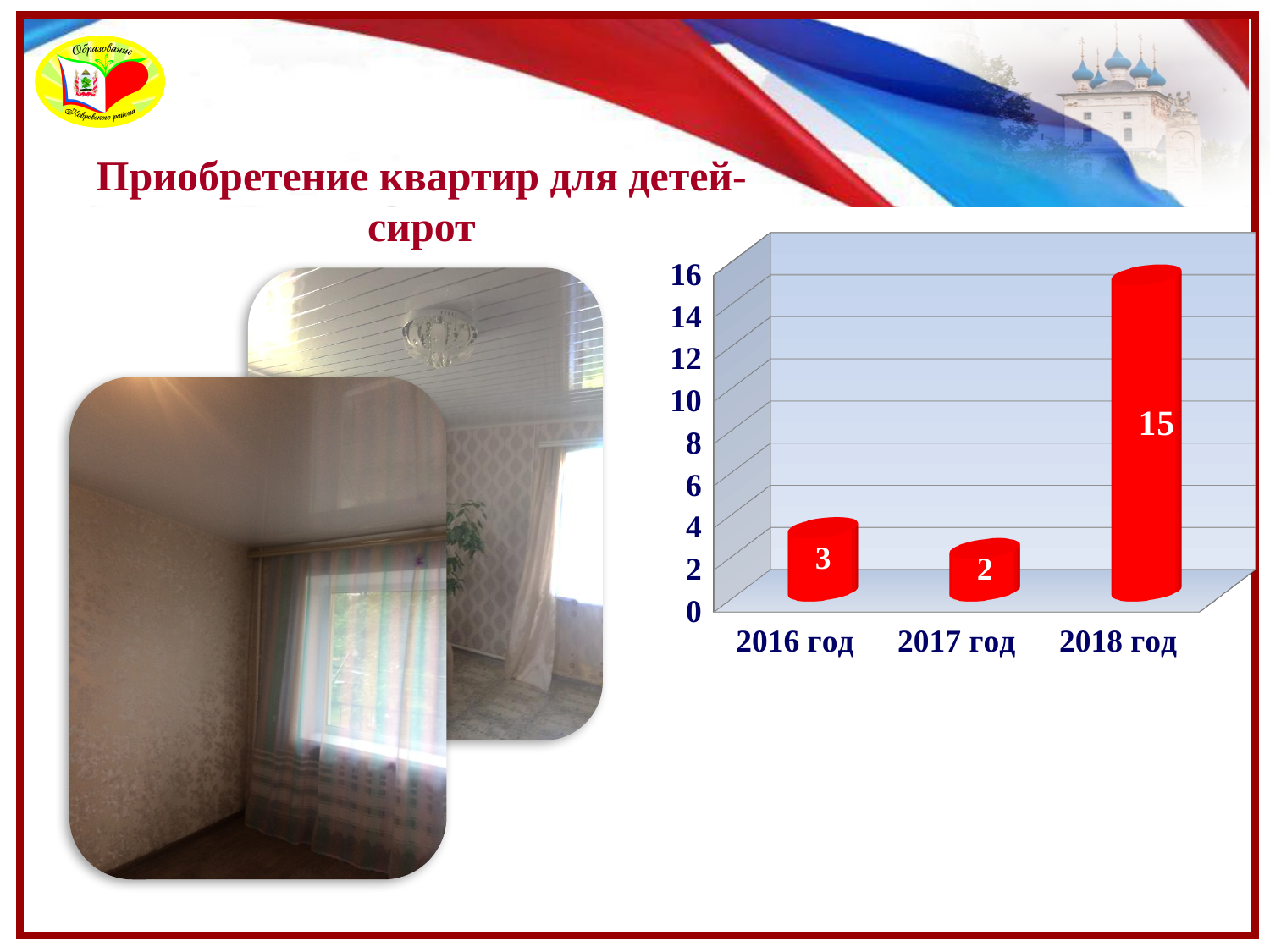
How many years are shown on the chart? 3 Which year has the highest value? 2018 год What is the difference between the values for 2018 год and 2016 год? 12 Which year has the lowest value? 2017 год What colour are the bars in the chart? red Is the value for 2018 год greater or less than 10? greater Which is larger, the value for 2016 год or 2017 год? 2016 год What is the value for 2018 год? 15 What kind of chart is shown on the slide? bar chart What is the difference between the values for 2016 год and 2017 год? 1 What is the value for 2017 год? 2 What is the value for 2016 год? 3